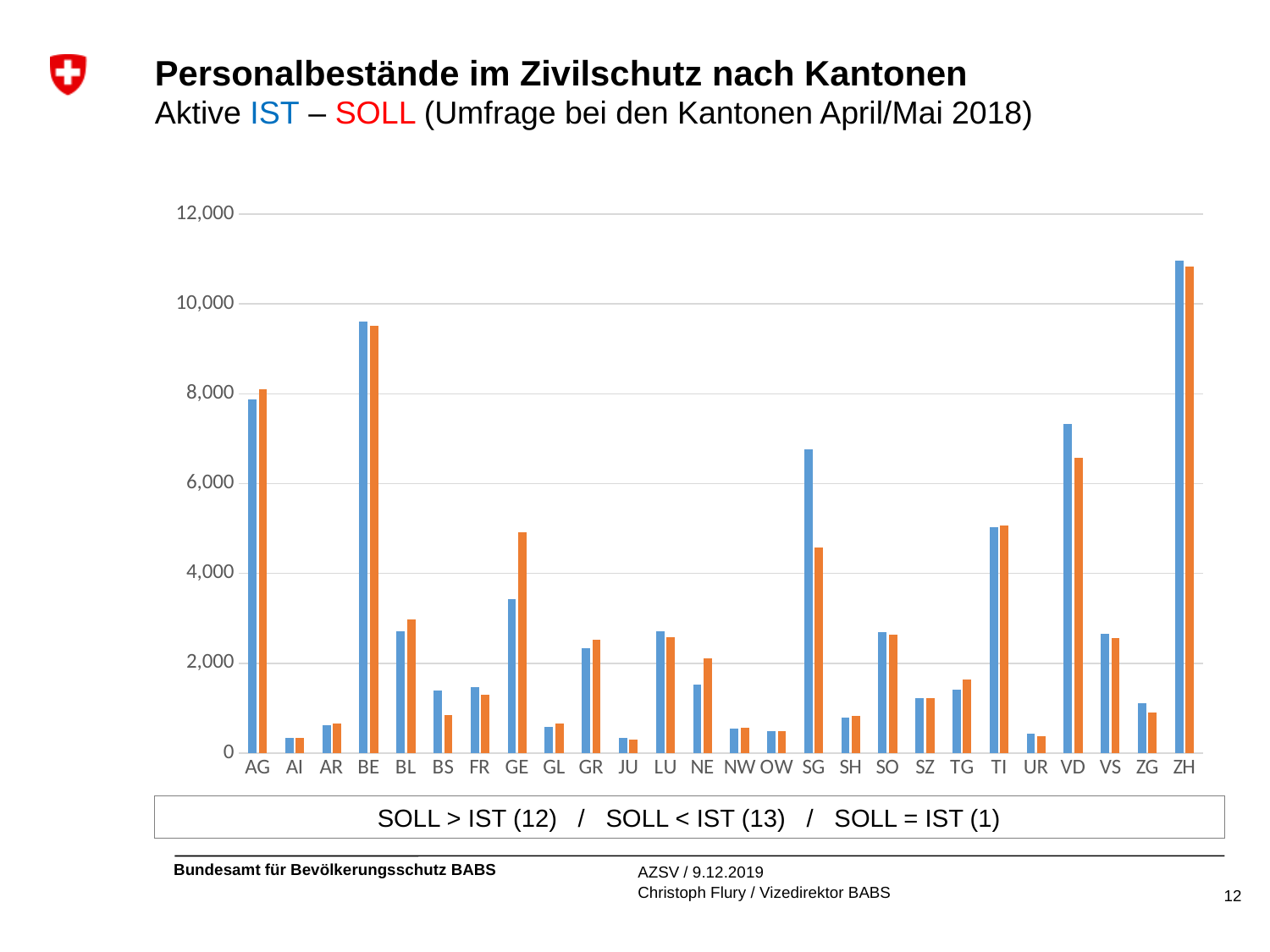
For VD, which is larger, the IST value or the SOLL value? IST Which canton has the highest IST (blue) value? ZH Is the SOLL value for GE greater or less than 4,000? greater Is the IST value for ZH greater or less than 10,000? greater Is the IST value for BE greater or less than 8,000? greater For GE, which is larger, the IST value or the SOLL value? SOLL How many data series (bars per canton) does the chart show? 2 What kind of chart is shown on the slide? bar chart How many cantons are shown on the x axis of the chart? 26 Which canton has the highest SOLL (orange) value? ZH